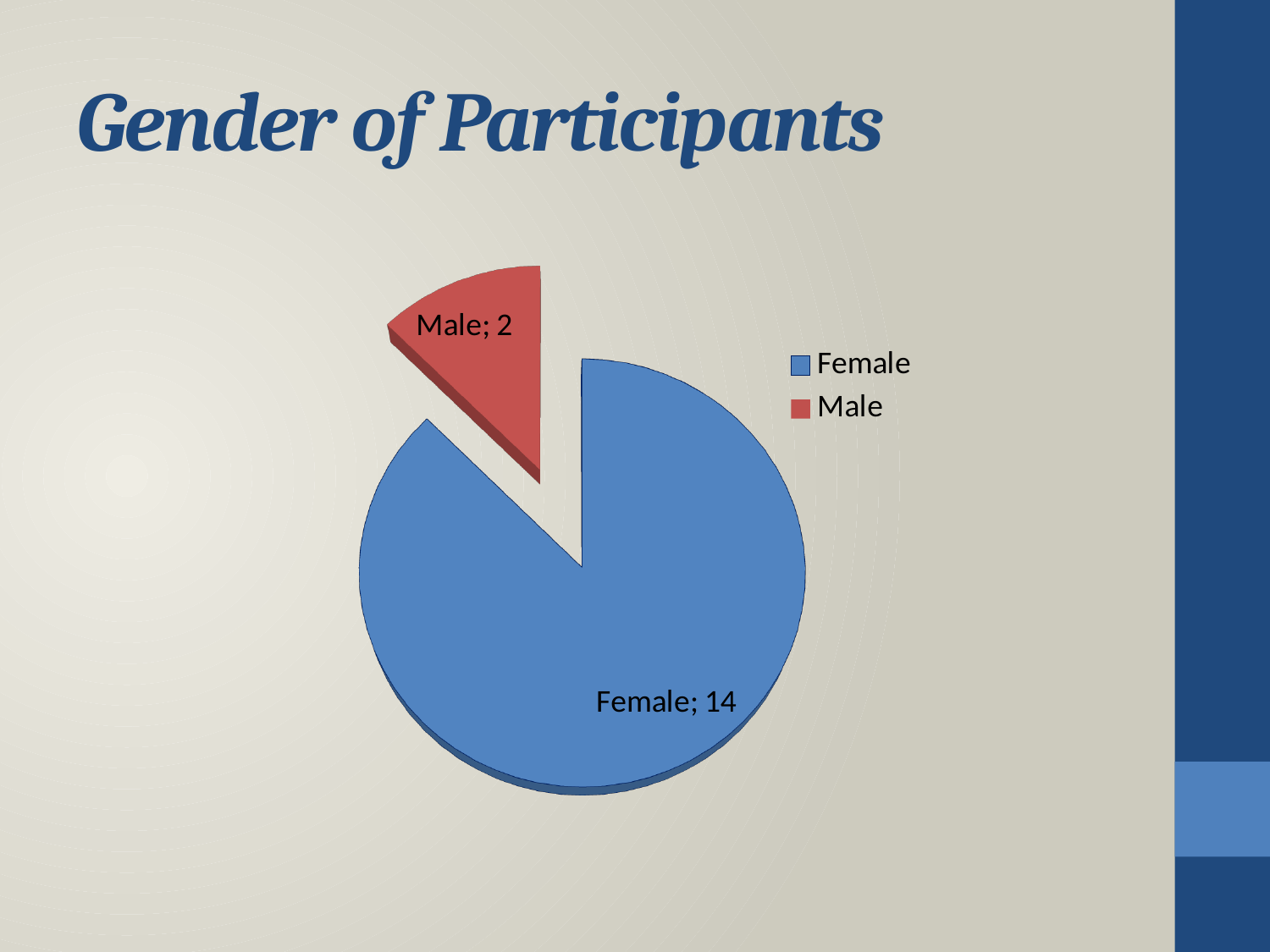
Which category has the smallest slice of the pie? Male How many categories are shown in the pie chart? 2 What kind of chart is shown on the slide? Pie chart Which is larger, the value for Female or the value for Male? Female What share of the pie does the Male slice represent? 12.5% What is the difference between the Female and Male values? 12 Which category has the largest slice of the pie? Female What is the total of all slices in the pie chart? 16 What is the value for Male in the pie chart? 2 What is the value for Female in the pie chart? 14 What is the title of the slide containing the chart? Gender of Participants How many entries does the legend list? 2